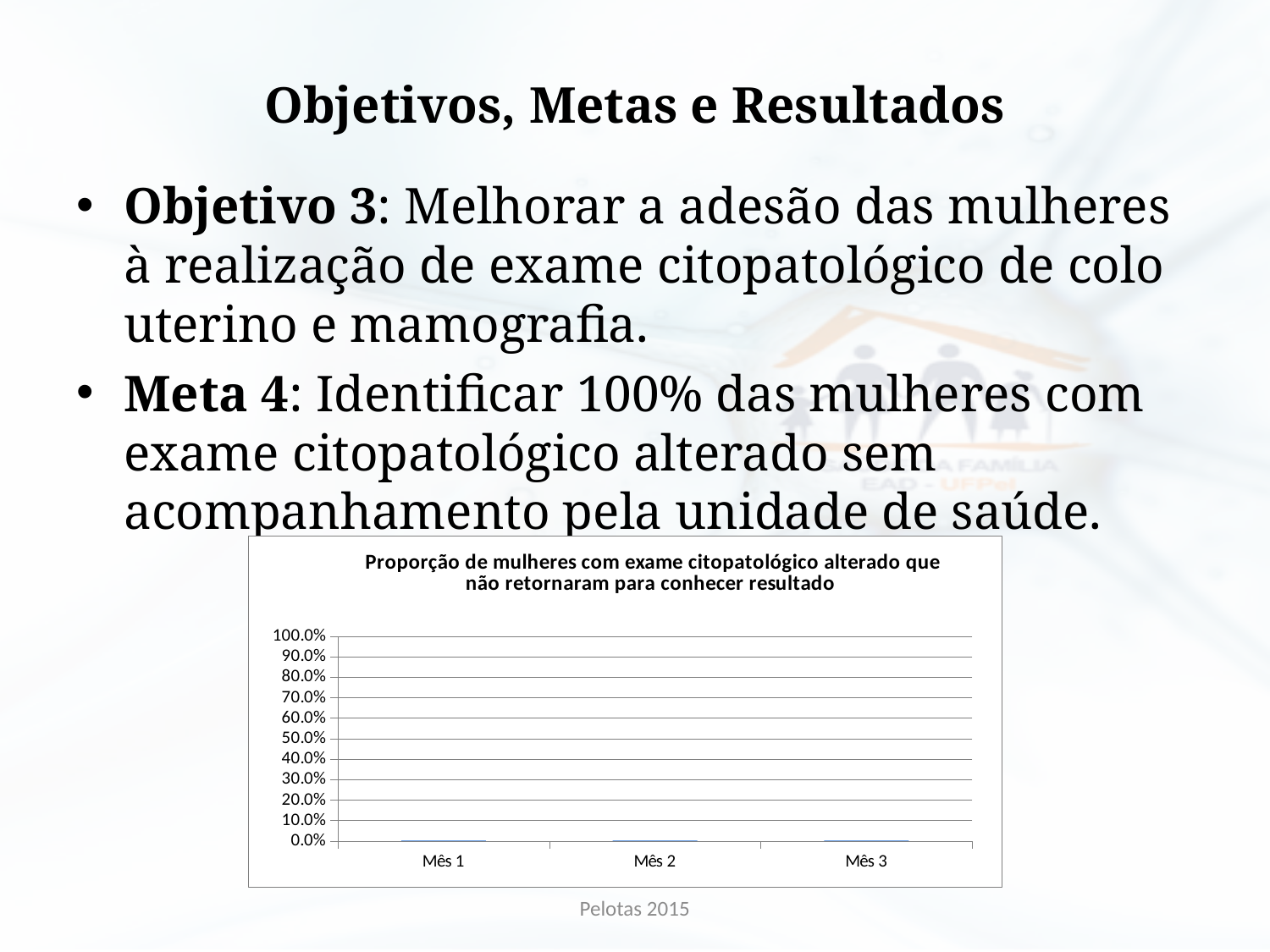
Is the value for Mês 1 greater or less than 10.0%? less What kind of chart is shown on the slide? bar chart What is the title of the chart? Proporção de mulheres com exame citopatológico alterado que não retornaram para conhecer resultado Is the value for Mês 2 greater or less than 10.0%? less How many categories are shown on the x axis of the chart? 3 Is the value for Mês 3 greater or less than 50.0%? less What is the label of the first category on the x axis? Mês 1 What is the highest value shown on the y axis of the chart? 100.0% What is the label of the last category on the x axis? Mês 3